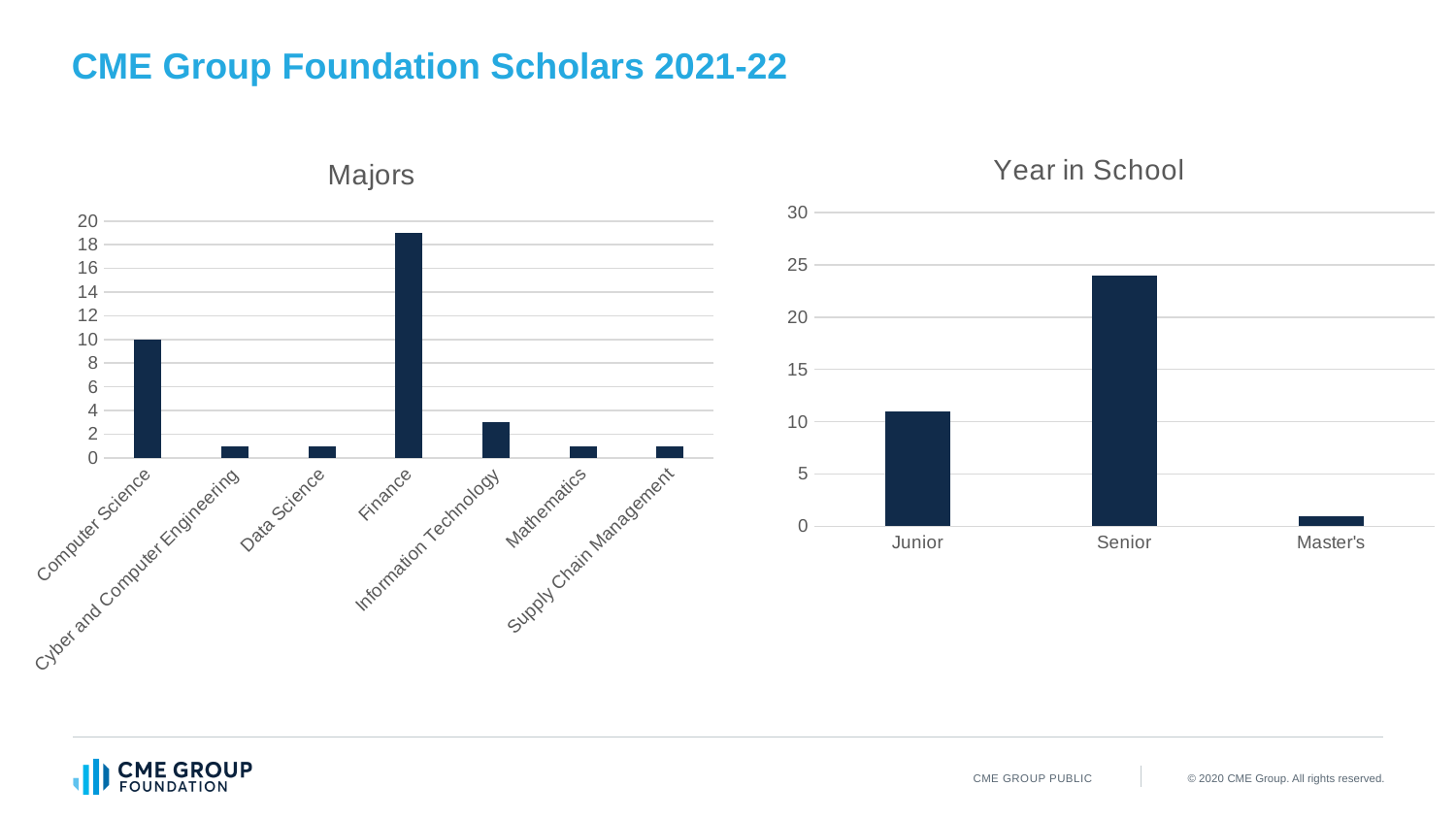
On the Year in School chart, which category has the lowest value? Master's On the Majors chart, which major has the highest value? Finance On the Majors chart, what is the value for Computer Science? 10 On the Majors chart, how many majors are shown? 7 On the Year in School chart, is the value for Junior greater or less than 15? less On the Majors chart, which is larger, Computer Science or Information Technology? Computer Science On the Year in School chart, is the value for Senior greater or less than 20? greater On the Year in School chart, which category has the highest value? Senior On the Majors chart, is the value for Information Technology greater or less than 4? less On the Year in School chart, how many categories are shown? 3 What type of chart is the Year in School chart? Bar chart